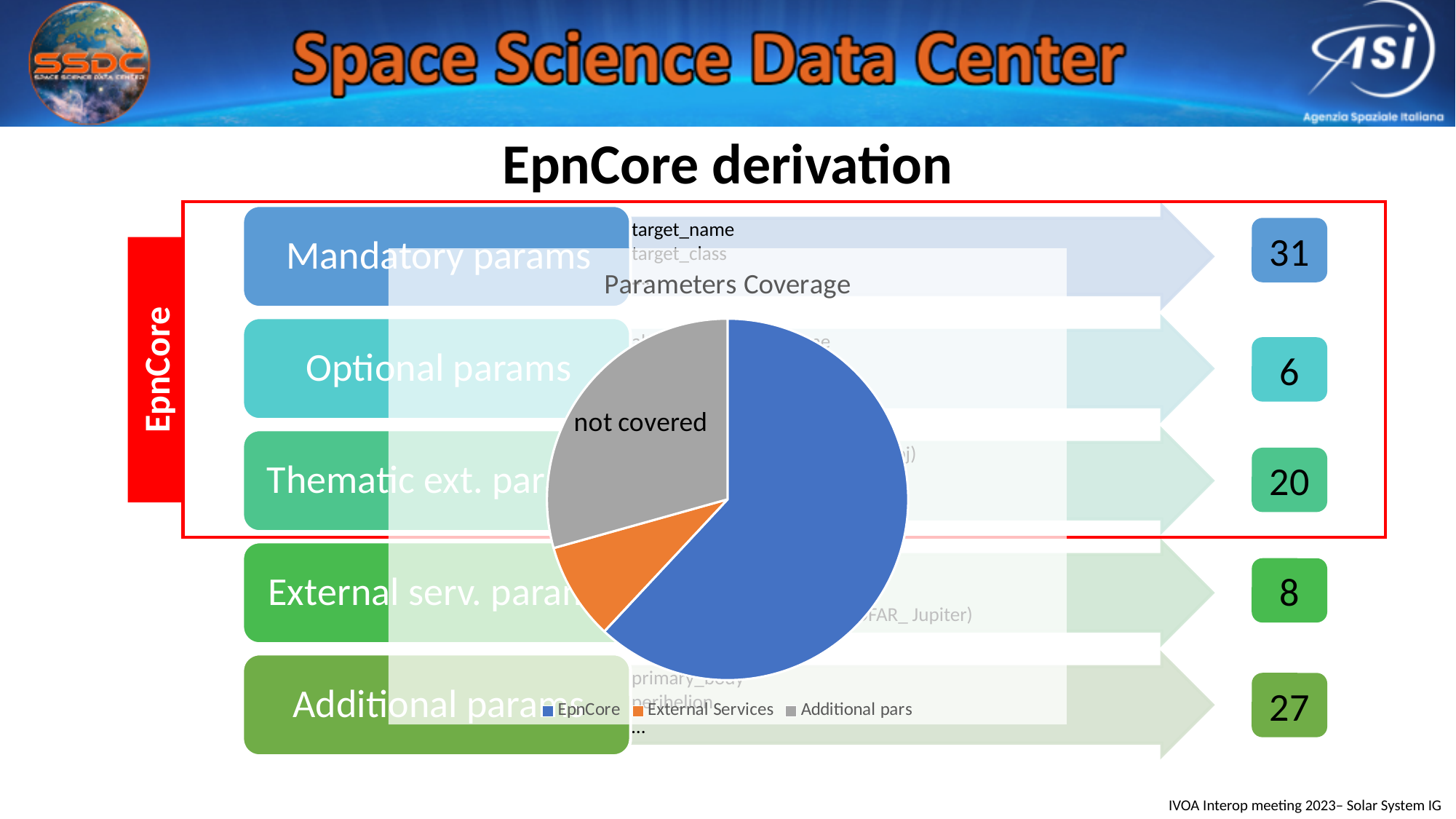
Which slice is larger, EpnCore or Additional pars? EpnCore Which colour represents EpnCore in the pie chart? blue What kind of chart is shown on the slide? pie chart Which category has the largest slice of the pie? EpnCore How many slices does the pie chart have? 3 How many entries does the chart legend list? 3 What is the title of the chart? Parameters Coverage Which slice of the pie is labelled "not covered"? Additional pars Which category has the smallest slice of the pie? External Services Which slice is larger, Additional pars or External Services? Additional pars